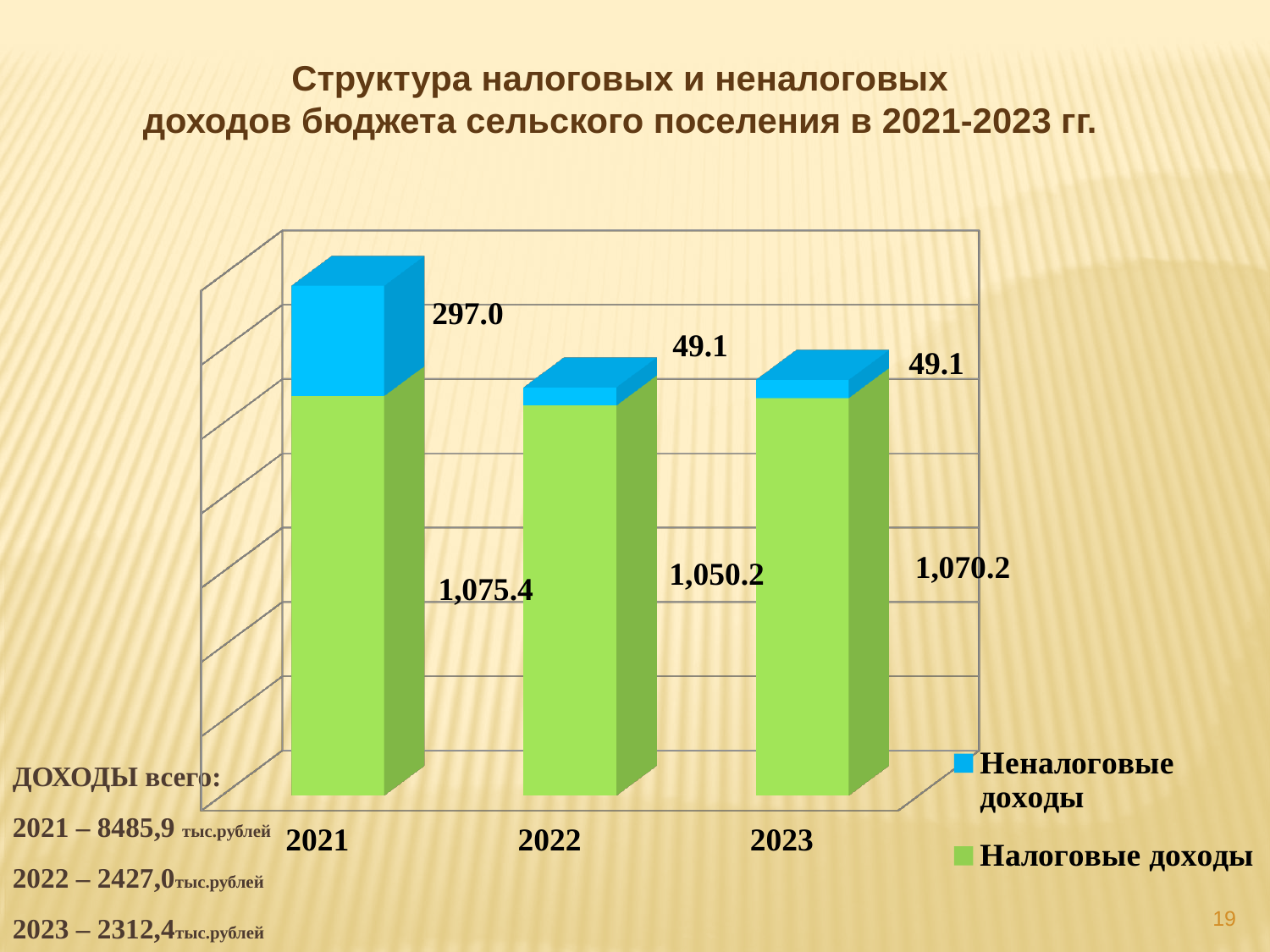
How many series does the legend list? 2 In which year is Налоговые доходы the lowest? 2022 What is the value of Налоговые доходы for 2022? 1,050.2 What is the difference between Налоговые доходы in 2023 and in 2022? 20.0 What is the value of Неналоговые доходы for 2021? 297.0 What type of chart is shown on the slide? Stacked bar chart What is the value of Налоговые доходы for 2021? 1,075.4 What is the value of Неналоговые доходы for 2023? 49.1 What is the total of the stacked bar for 2022? 1,099.3 Which is larger: Налоговые доходы in 2021 or in 2023? 2021 What is the difference between Неналоговые доходы in 2021 and in 2022? 247.9 In which year is Неналоговые доходы the highest? 2021